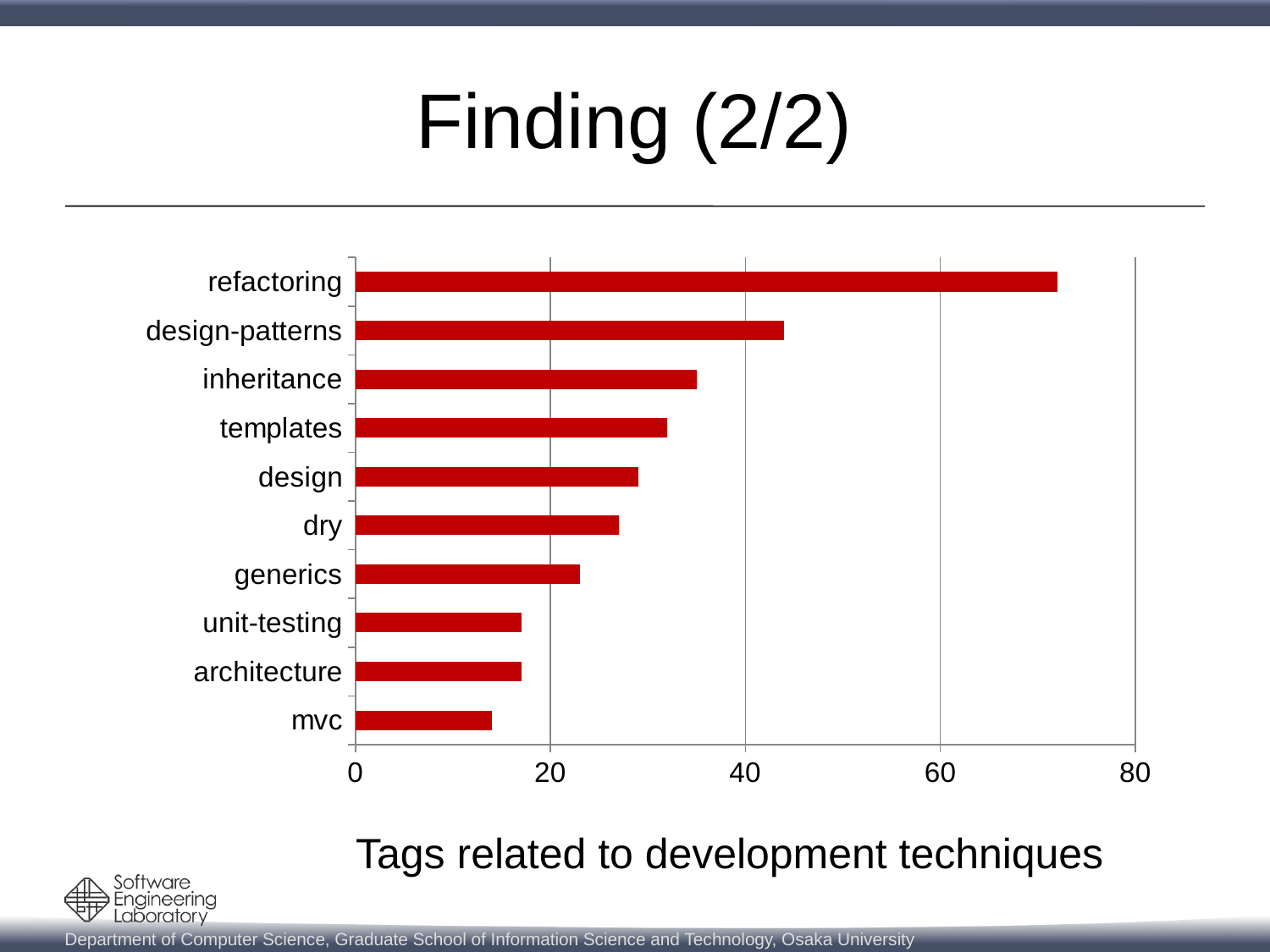
Which has a larger value, refactoring or design-patterns? refactoring What kind of chart is shown on the slide? bar chart Which tag has the highest value in the chart? refactoring Is the value for inheritance greater or less than 40? less Which tag has the lowest value in the chart? mvc How many tags (categories) are plotted in the chart? 10 Is the value for design-patterns greater or less than 40? greater What is the caption shown below the chart? Tags related to development techniques Is the value for mvc greater or less than 20? less Which has a larger value, dry or generics? dry